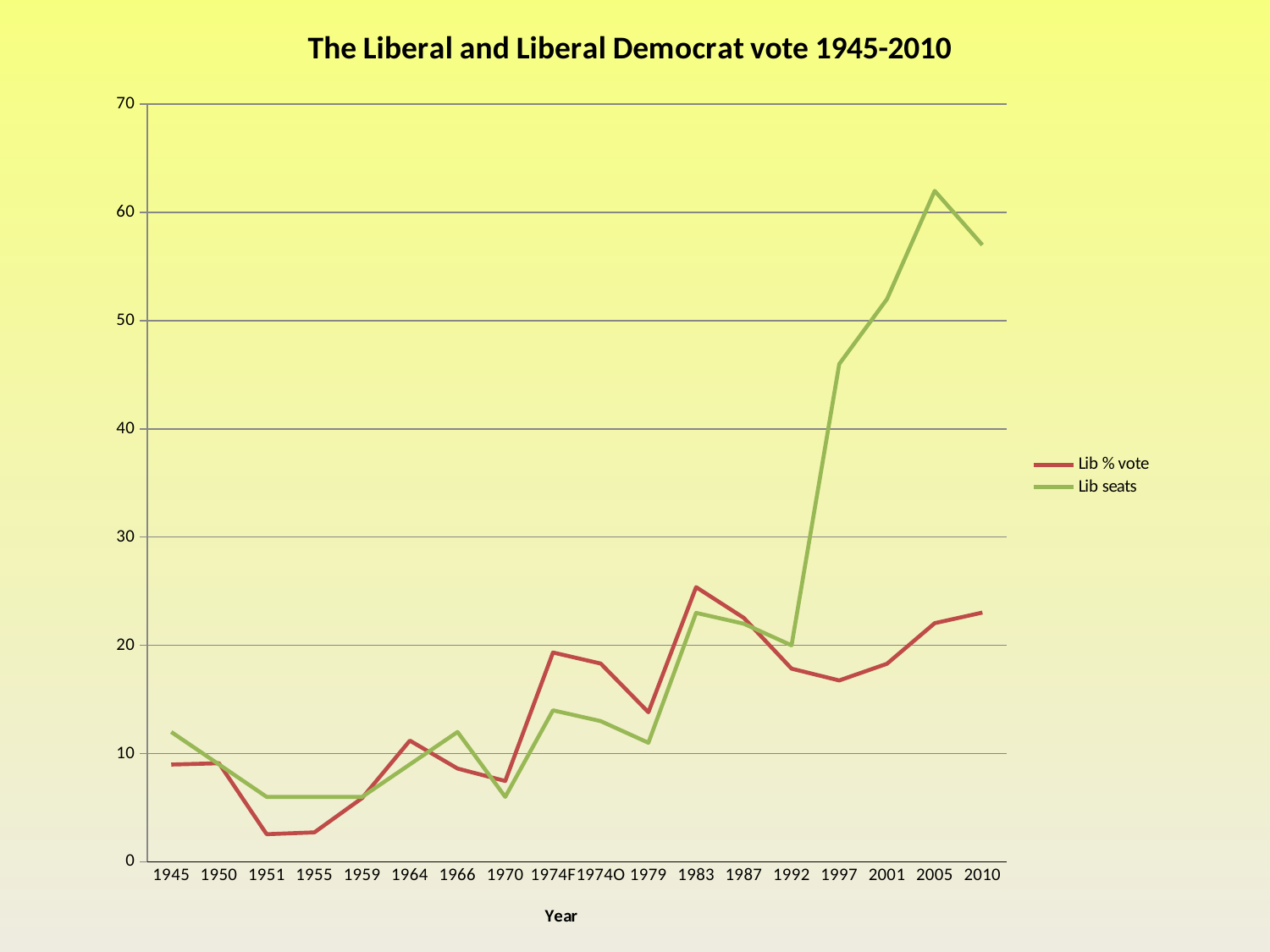
What is the title of the chart? The Liberal and Liberal Democrat vote 1945-2010 What kind of chart is shown on the slide? Line chart Is the value for Lib % vote in 1951 greater or less than 10? less In which year does the Lib seats series reach its highest value? 2005 How many series does the legend list? 2 Does the Lib seats series rise or fall between 1992 and 2005? Rise In which year does the Lib % vote series reach its highest value? 1983 Is the value for Lib seats in 2010 greater or less than 60? less How many election years are plotted along the x axis? 18 In 1997, which series has the larger value, Lib % vote or Lib seats? Lib seats Is the value for Lib seats in 1997 greater or less than 40? greater